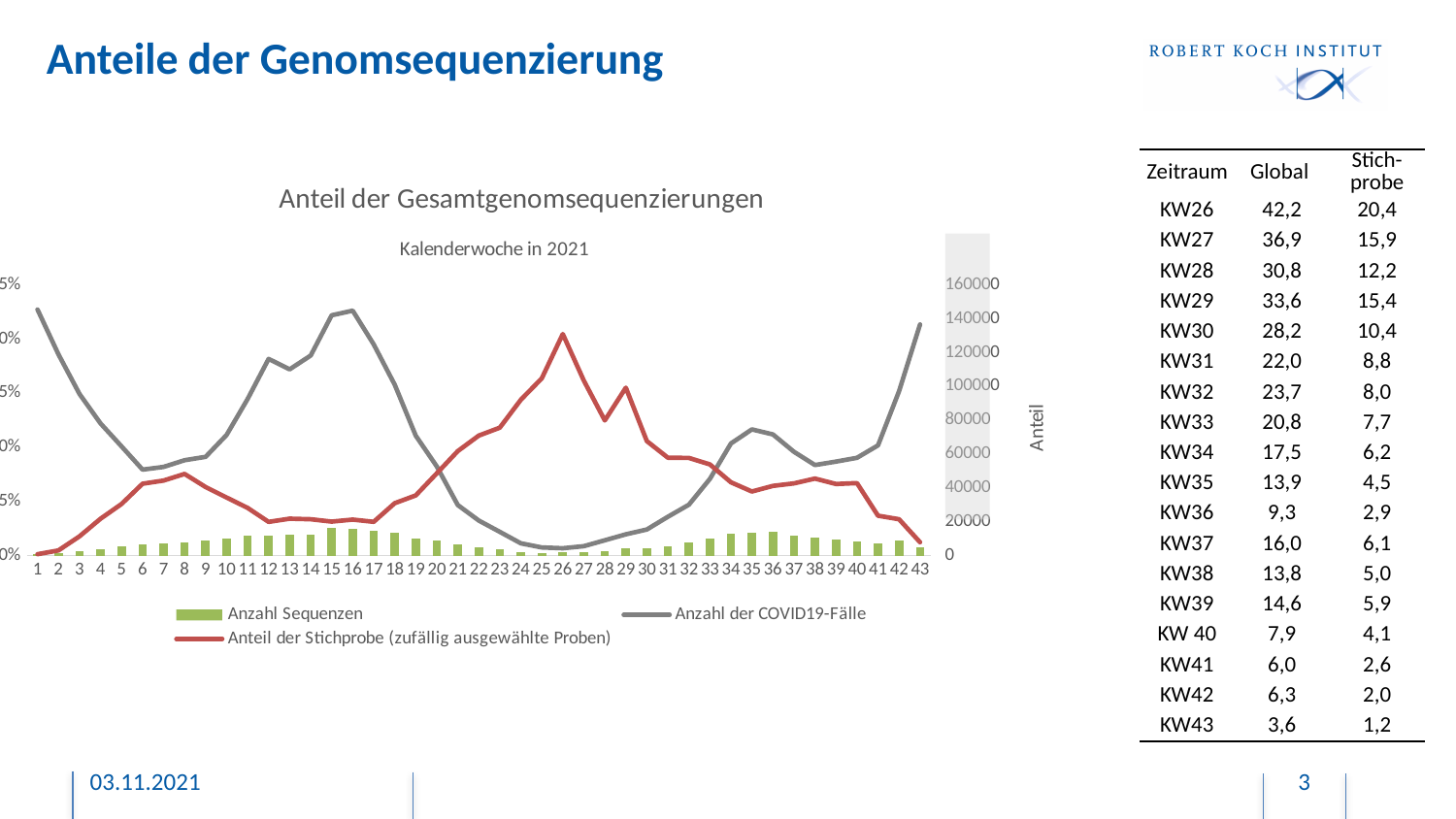
Is the value of Anzahl der COVID19-Fälle in week 25 greater or less than 20000? less Does the Anzahl der COVID19-Fälle line rise or fall from week 36 to week 43? Rise What is the title of the chart? Anteil der Gesamtgenomsequenzierungen How many calendar weeks are plotted along the x axis of the chart? 43 Which week has more COVID19-Fälle, week 12 or week 20? Week 12 In which calendar week does the Anteil der Stichprobe (zufällig ausgewählte Proben) line reach its highest point? 26 What kind of chart is shown on the slide? Combined bar and line chart Which series in the chart is drawn as green bars? Anzahl Sequenzen Is the value of Anzahl der COVID19-Fälle in week 16 greater or less than 120000? greater Is the value of Anzahl der COVID19-Fälle in week 6 greater or less than 80000? less How many series does the chart legend list? 3